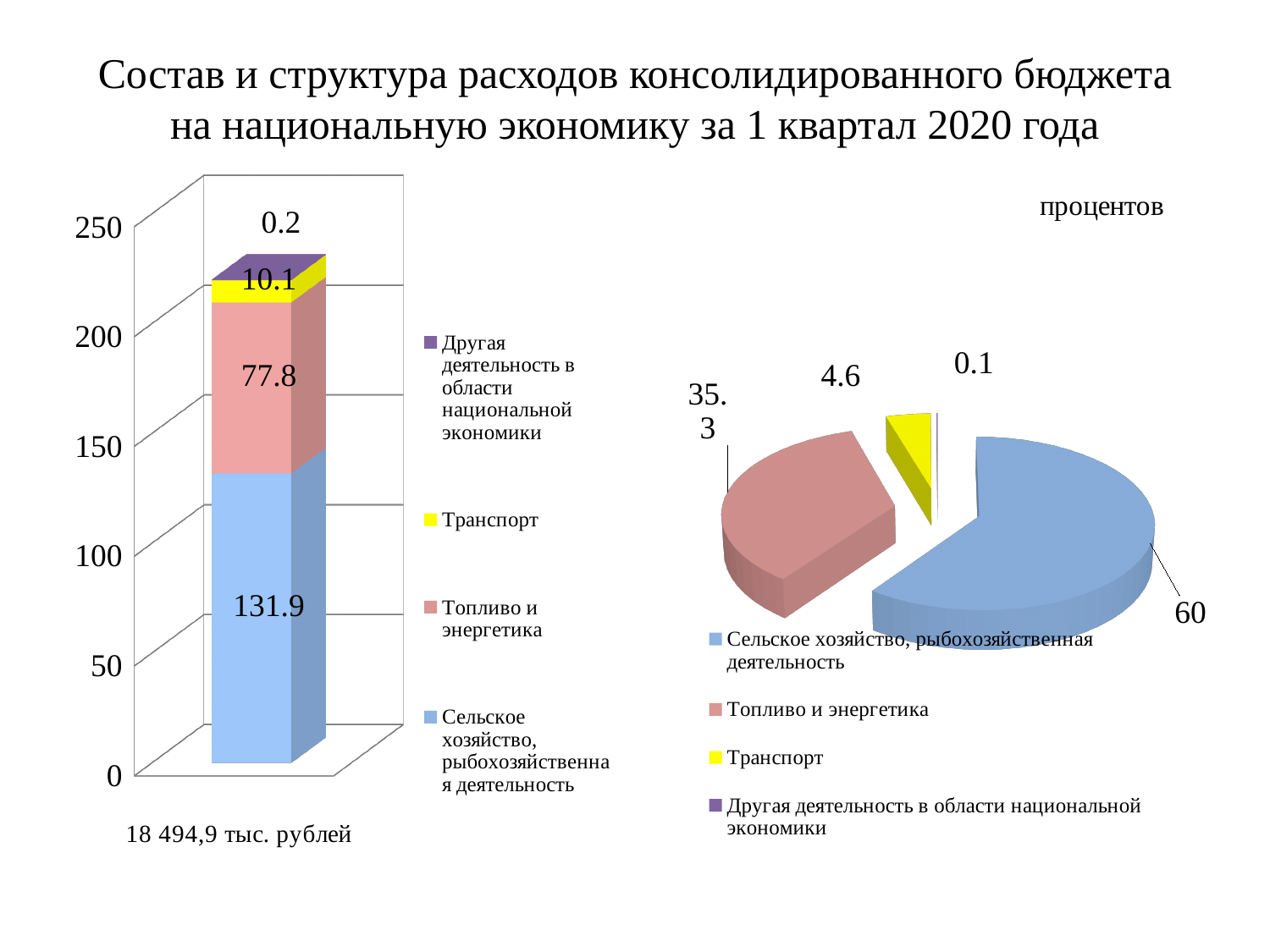
In the pie chart on the right, what is the value for Транспорт? 4.6 In the bar chart on the left, what is the value for Транспорт? 10.1 In the bar chart on the left, what is the total of the stacked bar? 220.0 What type of chart is on the left side of the slide? bar chart In the bar chart on the left, what is the value for Сельское хозяйство, рыбохозяйственная деятельность? 131.9 In the bar chart on the left, what is the difference between Сельское хозяйство, рыбохозяйственная деятельность and Топливо и энергетика? 54.1 In the pie chart on the right, which category has the smallest slice? Другая деятельность в области национальной экономики In the pie chart on the right, what share does Сельское хозяйство, рыбохозяйственная деятельность have? 60 How many entries does the legend of the pie chart on the right list? 4 In the bar chart on the left, what is the value for Топливо и энергетика? 77.8 What type of chart is on the right side of the slide? pie chart In the bar chart on the left, what is the value for Другая деятельность в области национальной экономики? 0.2